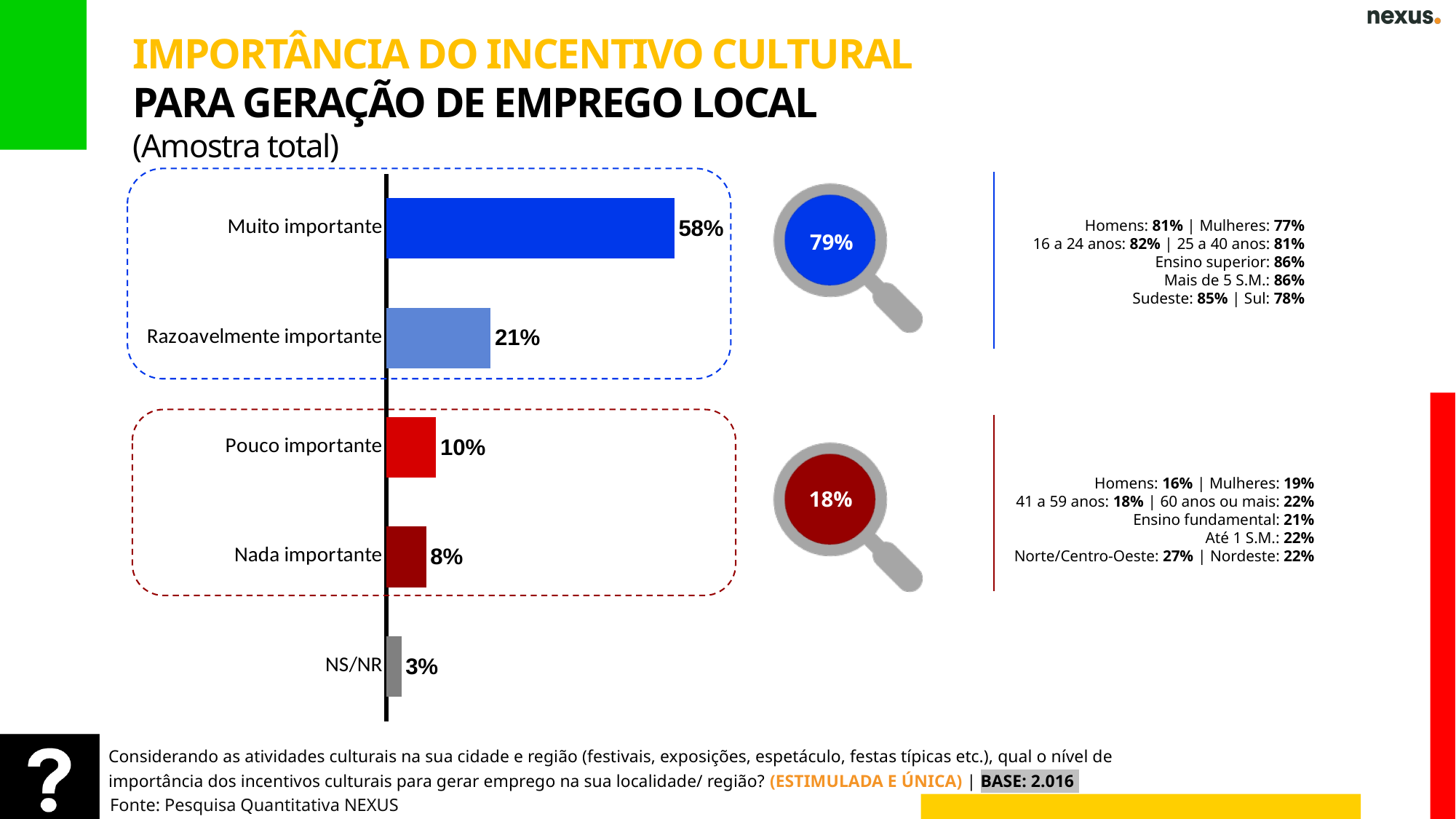
Which is larger, "Pouco importante" or "Nada importante"? Pouco importante What is the value for "NS/NR"? 3% Which category has the lowest value? NS/NR What is the combined total of "Muito importante" and "Razoavelmente importante" shown in the blue magnifier? 79% What kind of chart is shown on the slide? Bar chart What is the value for "Pouco importante"? 10% What is the value for "Nada importante"? 8% What is the difference between "Muito importante" and "Razoavelmente importante"? 37% Which category has the highest value? Muito importante What is the value for "Razoavelmente importante"? 21% What is the value for "Muito importante"? 58% How many categories are shown in the bar chart? 5